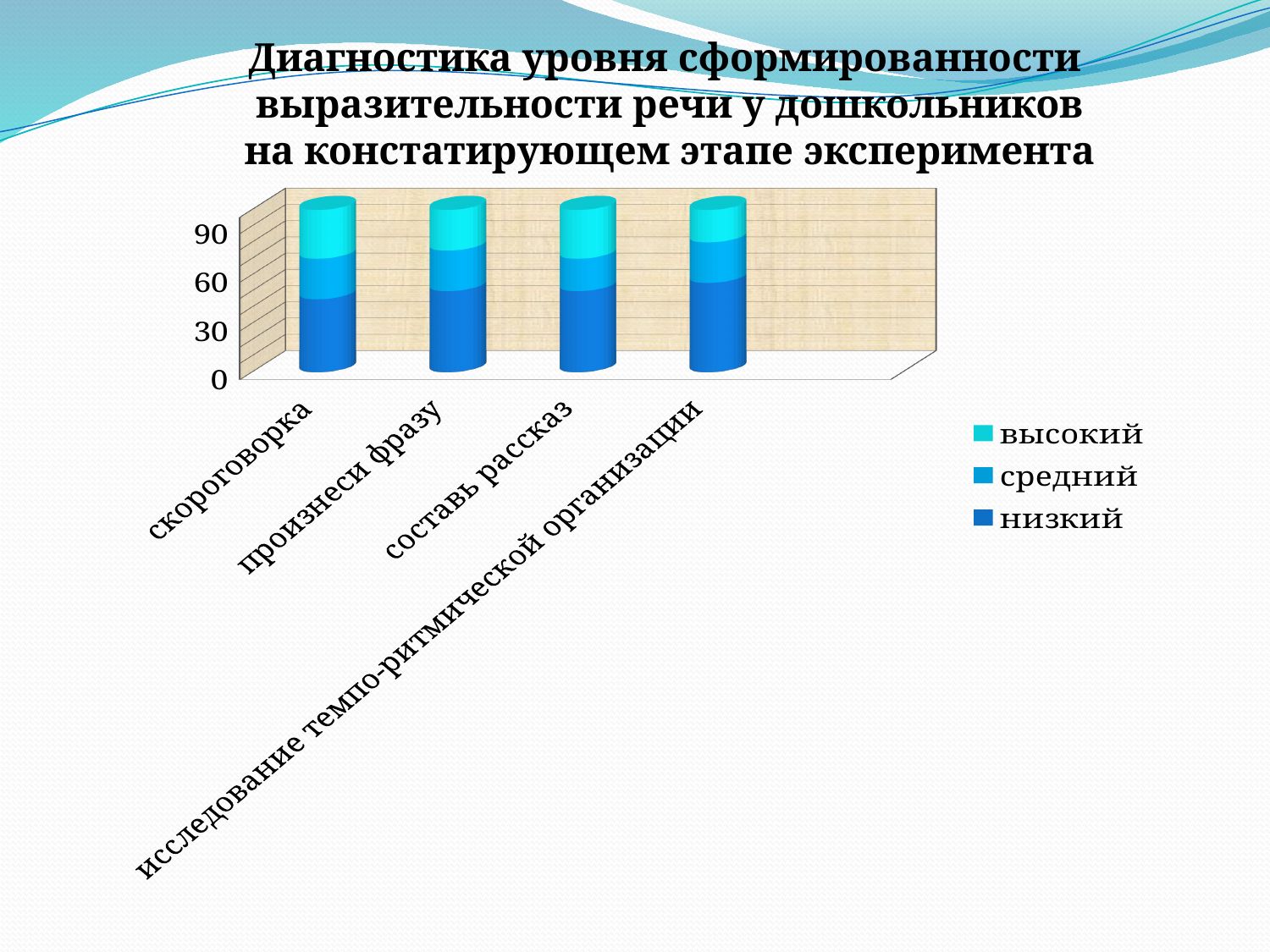
Is the value of the высокий segment for скороговорка greater or less than 60? less Is the value of the низкий segment for произнеси фразу greater or less than 90? less How many categories are shown along the x axis of the chart? 4 Which has the larger низкий segment: скороговорка or исследование темпо-ритмической организации? исследование темпо-ритмической организации Is the value of the низкий segment for скороговорка greater or less than 30? greater What kind of chart is shown on the slide? bar chart Which category has the largest низкий segment? исследование темпо-ритмической организации How many series does the chart's legend list? 3 What are the three series listed in the chart's legend? высокий, средний, низкий Which series is shown in the darkest blue at the bottom of each bar? низкий What is the highest tick value shown on the vertical axis? 90